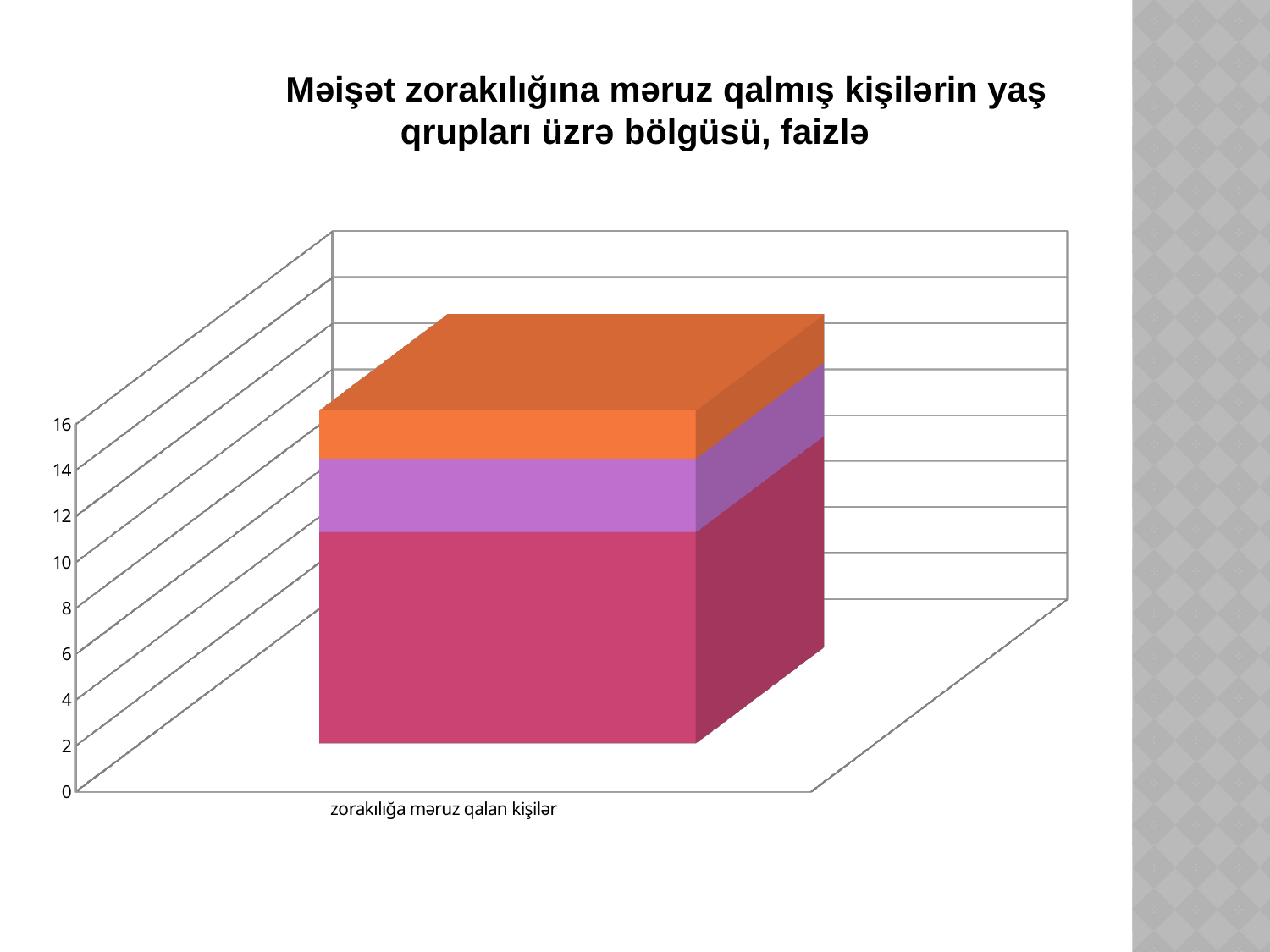
What kind of chart is shown on the slide? A stacked bar chart How many categories are plotted on the x axis of the chart? 1 What is the highest value shown on the vertical axis of the chart? 16 Is the red (bottom) segment of the bar larger or smaller than the purple (middle) segment? larger Which coloured segment of the stacked bar is the smallest? The orange (top) segment What is the title of the chart? Məişət zorakılığına məruz qalmış kişilərin yaş qrupları üzrə bölgüsü, faizlə How many stacked segments make up the bar in the chart? 3 Which coloured segment of the stacked bar is the largest? The red (bottom) segment What is the label of the single category on the x axis? zorakılığa məruz qalan kişilər